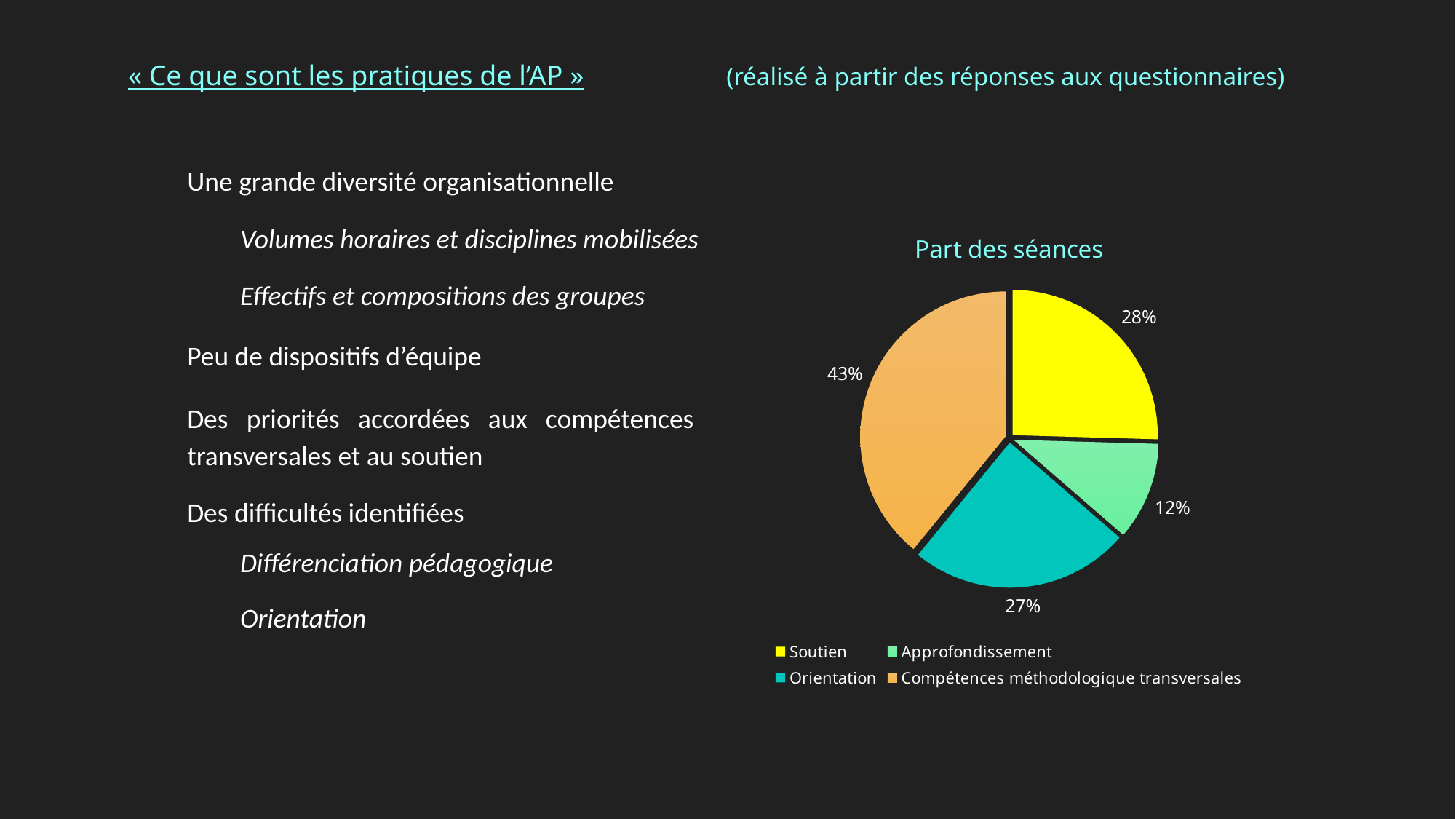
What share of the pie does Compétences méthodologique transversales represent? 43% What share of the pie does Orientation represent? 27% Which category has the smallest share of the pie? Approfondissement How many categories does the pie chart have? 4 What share of the pie does Soutien represent? 28% Which category has the largest share of the pie? Compétences méthodologique transversales What colour is the Soutien slice? yellow Which is larger, the share for Soutien or the share for Approfondissement? Soutien What kind of chart is shown on the slide? pie chart What is the title of the chart? Part des séances What is the difference in percentage points between Compétences méthodologique transversales and Soutien? 15